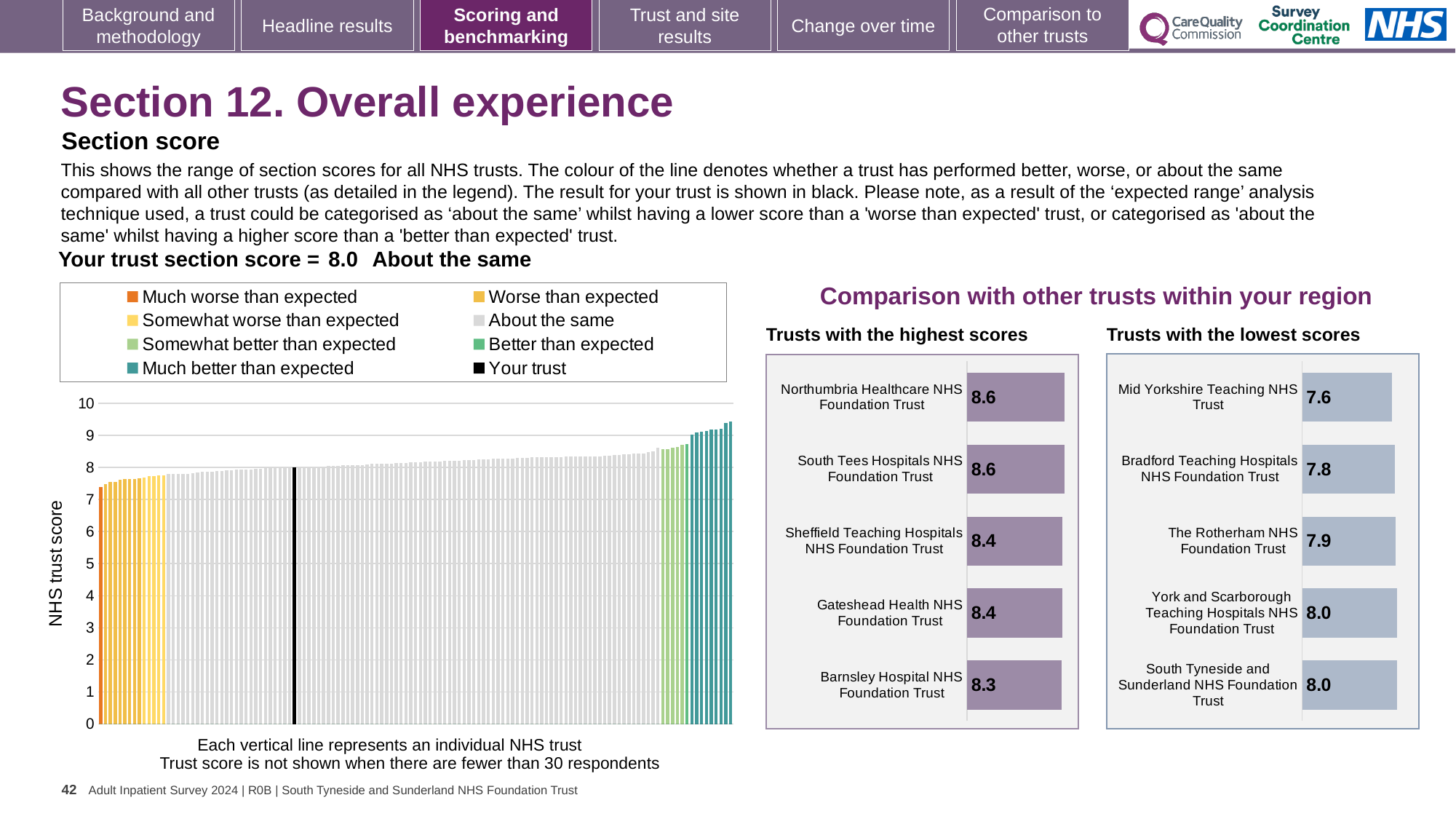
In the 'Trusts with the lowest scores' chart, which is larger: the score for Bradford Teaching Hospitals NHS Foundation Trust or the score for Mid Yorkshire Teaching NHS Trust? Bradford Teaching Hospitals NHS Foundation Trust In the 'Trusts with the highest scores' chart, what is the difference between the scores of Northumbria Healthcare NHS Foundation Trust and Barnsley Hospital NHS Foundation Trust? 0.3 In the 'Trusts with the highest scores' chart, what is the score for Barnsley Hospital NHS Foundation Trust? 8.3 In the 'Trusts with the highest scores' chart, which trust has the lowest score? Barnsley Hospital NHS Foundation Trust In the 'Trusts with the highest scores' chart, what is the score for Northumbria Healthcare NHS Foundation Trust? 8.6 In the 'Trusts with the lowest scores' chart, what is the difference between the scores of York and Scarborough Teaching Hospitals NHS Foundation Trust and Mid Yorkshire Teaching NHS Trust? 0.4 In the main 'NHS trust score' chart on the left, is the value for 'Your trust' greater or less than 9? less In the main 'NHS trust score' chart on the left, how many entries does the legend list? 8 In the 'Trusts with the highest scores' chart, how many trusts are shown? 5 In the 'Trusts with the lowest scores' chart, what is the score for Mid Yorkshire Teaching NHS Trust? 7.6 In the 'Trusts with the lowest scores' chart, which trust has the lowest score? Mid Yorkshire Teaching NHS Trust In the main 'NHS trust score' chart on the left, do the trust scores rise or fall from left to right along the x axis? rise